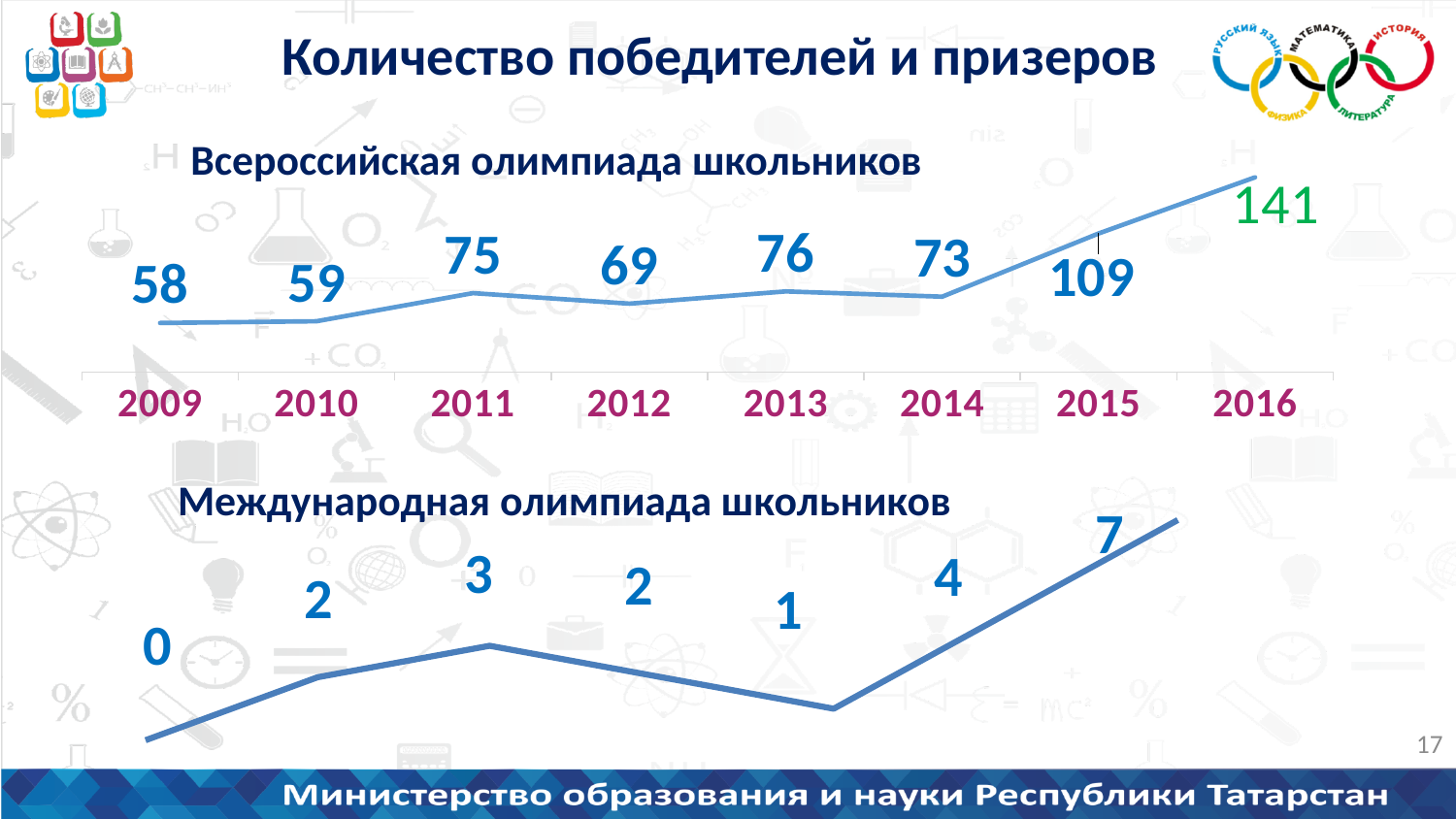
What kind of chart is the chart titled 'Международная олимпиада школьников'? line chart In the chart titled 'Всероссийская олимпиада школьников', which is larger, the value for 2013 or the value for 2014? 2013 In the chart titled 'Всероссийская олимпиада школьников', which year has the lowest value? 2009 In the chart titled 'Всероссийская олимпиада школьников', what is the difference between the values for 2016 and 2015? 32 In the chart titled 'Международная олимпиада школьников', what is the value of the first data point? 0 In the chart titled 'Международная олимпиада школьников', what is the value of the last data point? 7 How many data points are plotted in the chart titled 'Международная олимпиада школьников'? 7 How many years are shown on the x axis of the chart titled 'Всероссийская олимпиада школьников'? 8 In the chart titled 'Всероссийская олимпиада школьников', what is the value for 2016? 141 In the chart titled 'Всероссийская олимпиада школьников', which year has the highest value? 2016 In the chart titled 'Всероссийская олимпиада школьников', what is the value for 2011? 75 What is the main title at the top of the slide? Количество победителей и призеров